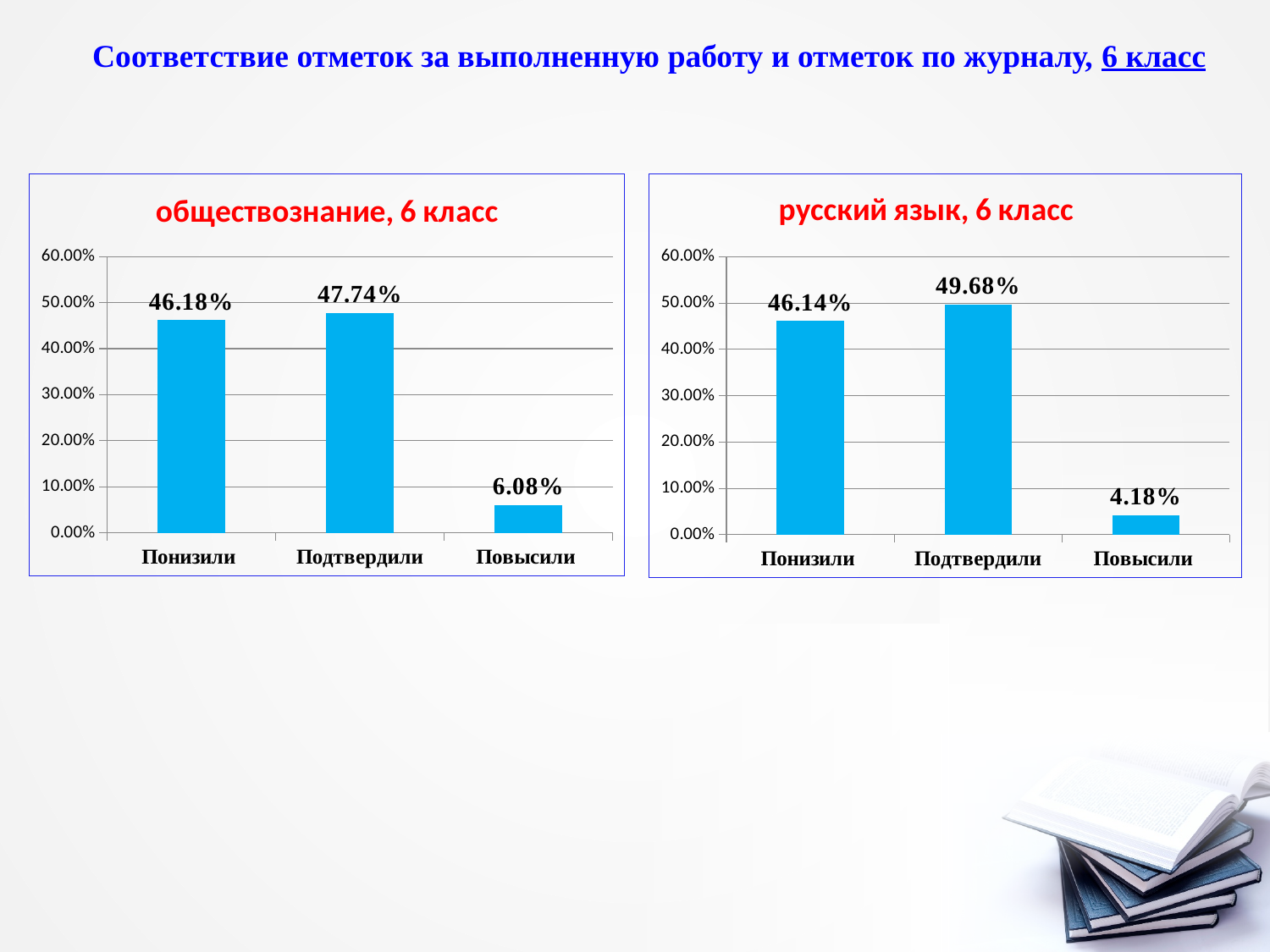
In the chart titled 'обществознание, 6 класс', what is the value for Понизили? 46.18% In the chart titled 'русский язык, 6 класс', what is the value for Подтвердили? 49.68% In the chart titled 'обществознание, 6 класс', which category has the highest value? Подтвердили In the chart titled 'русский язык, 6 класс', what is the difference between the values for Подтвердили and Понизили? 3.54% In the chart titled 'русский язык, 6 класс', which category has the lowest value? Повысили In the chart titled 'русский язык, 6 класс', which is larger, the value for Понизили or the value for Подтвердили? Подтвердили In the chart titled 'обществознание, 6 класс', is the value for Повысили greater or less than 10.00%? less What kind of chart is the chart titled 'русский язык, 6 класс'? bar chart In the chart titled 'обществознание, 6 класс', how many categories are shown on the x axis? 3 In the chart titled 'обществознание, 6 класс', what is the difference between the values for Подтвердили and Повысили? 41.66% In the chart titled 'обществознание, 6 класс', what is the value for Повысили? 6.08% In the chart titled 'русский язык, 6 класс', what is the value for Повысили? 4.18%